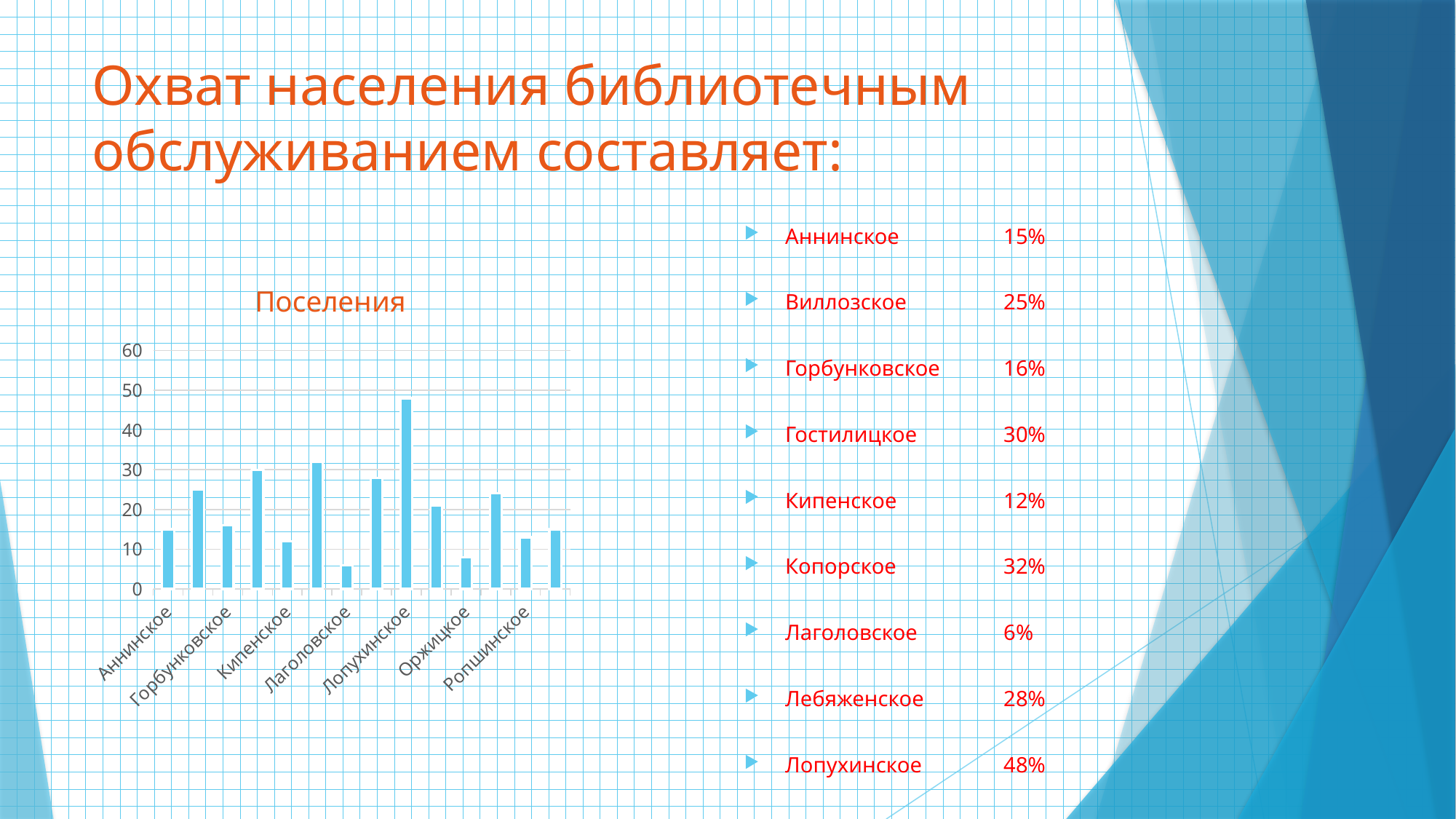
How many bars are plotted in the chart? 14 Is the value for Лаголовское greater or less than 10? less Is the value for Лопухинское greater or less than 40? greater Is the value for Ропшинское greater or less than 20? less Which is larger, the value for Горбунковское or the value for Лаголовское? Горбунковское What is the title of the chart? Поселения Which labelled settlement has the highest bar in the chart? Лопухинское According to the list on the slide, what is the library service coverage for Лопухинское? 48% What kind of chart is shown on the slide? bar chart Which is larger, the value for Лопухинское or the value for Аннинское? Лопухинское